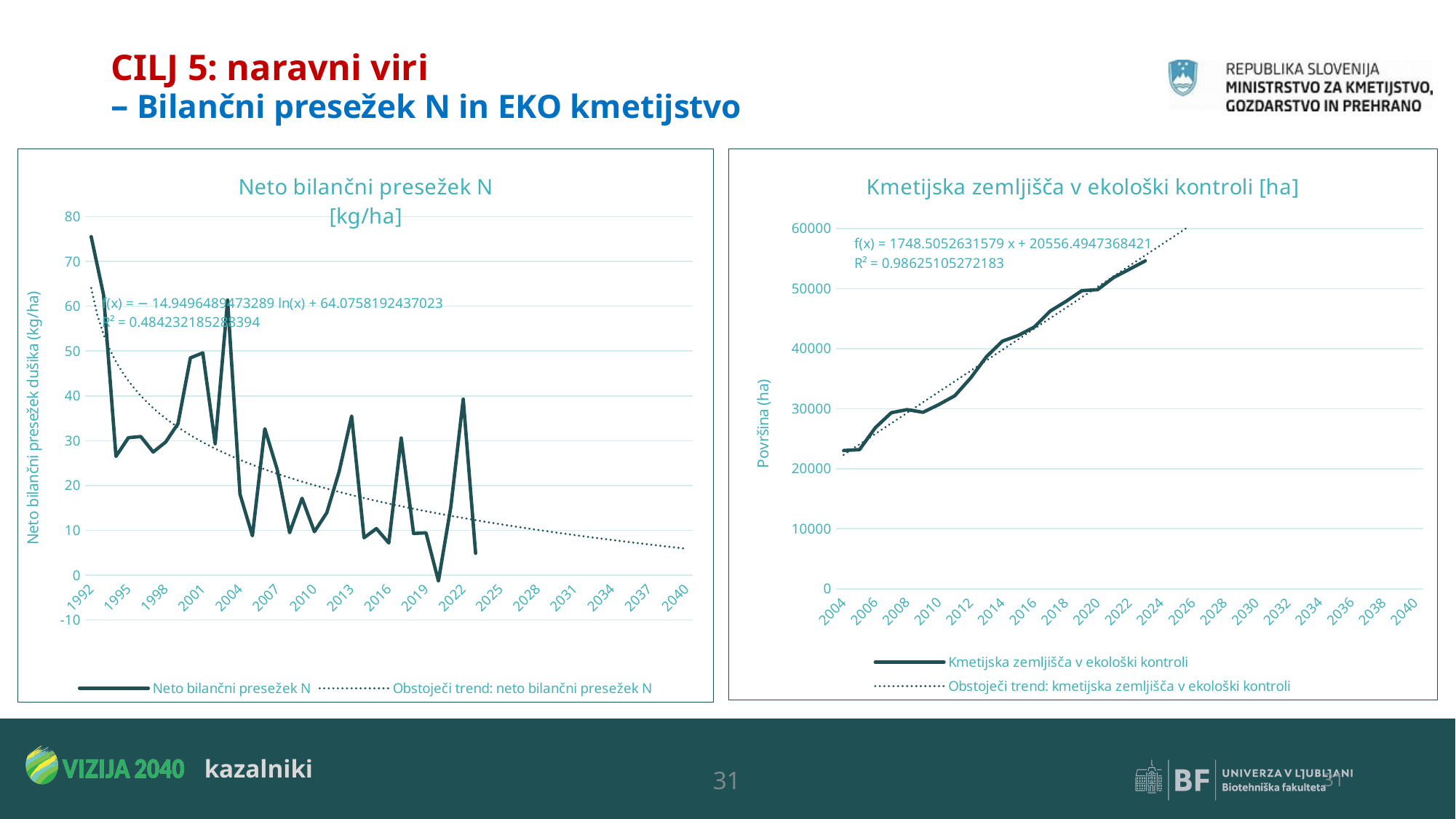
In the right chart "Kmetijska zemljišča v ekološki kontroli [ha]", is the last plotted value (2023) greater or less than 50000? greater How many series does the legend of the right chart "Kmetijska zemljišča v ekološki kontroli [ha]" list? 2 In the right chart "Kmetijska zemljišča v ekološki kontroli [ha]", what R² value is printed for the trend line? 0.98625105272183 In the left chart "Neto bilančni presežek N [kg/ha]", is the value for 1992 greater or less than 70? greater What kind of chart is the right chart titled "Kmetijska zemljišča v ekološki kontroli [ha]"? line chart In the left chart "Neto bilančni presežek N [kg/ha]", does the solid line for Neto bilančni presežek N generally rise or fall from 1992 to 2023? fall How many series does the legend of the left chart "Neto bilančni presežek N [kg/ha]" list? 2 In the right chart "Kmetijska zemljišča v ekološki kontroli [ha]", does the solid line generally rise or fall from 2004 to 2023? rise In the left chart "Neto bilančni presežek N [kg/ha]", is the last plotted value (2023) greater or less than 10? less What kind of chart is the left chart titled "Neto bilančni presežek N [kg/ha]"? line chart What is the second legend entry of the left chart "Neto bilančni presežek N [kg/ha]"? Obstoječi trend: neto bilančni presežek N